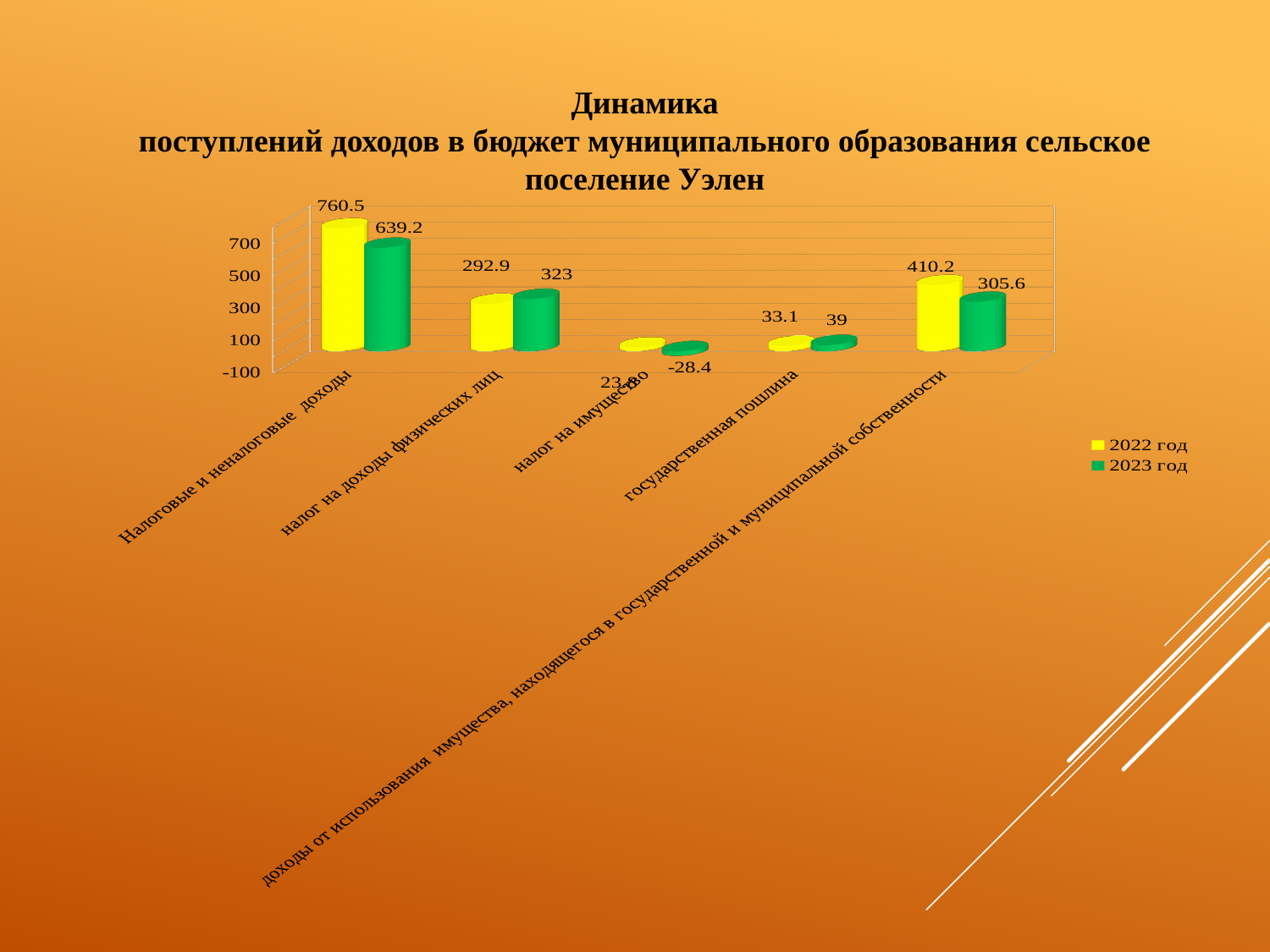
What is the value for Налоговые и неналоговые доходы in 2022 год? 760.5 What is the 2023 год value for налог на имущество? -28.4 What is the difference between the 2022 год and 2023 год values for Налоговые и неналоговые доходы? 121.3 What is the value for налог на доходы физических лиц in 2023 год? 323 What kind of chart is shown on the slide? Bar chart How many series does the legend list? 2 For налог на доходы физических лиц, which year has the larger value, 2022 год or 2023 год? 2023 год What is the value for Налоговые и неналоговые доходы in 2023 год? 639.2 What is the value for государственная пошлина in 2022 год? 33.1 Which category has the lowest value in the 2023 год series? налог на имущество How many categories are shown on the x axis? 5 Which category has the highest value in the 2022 год series? Налоговые и неналоговые доходы